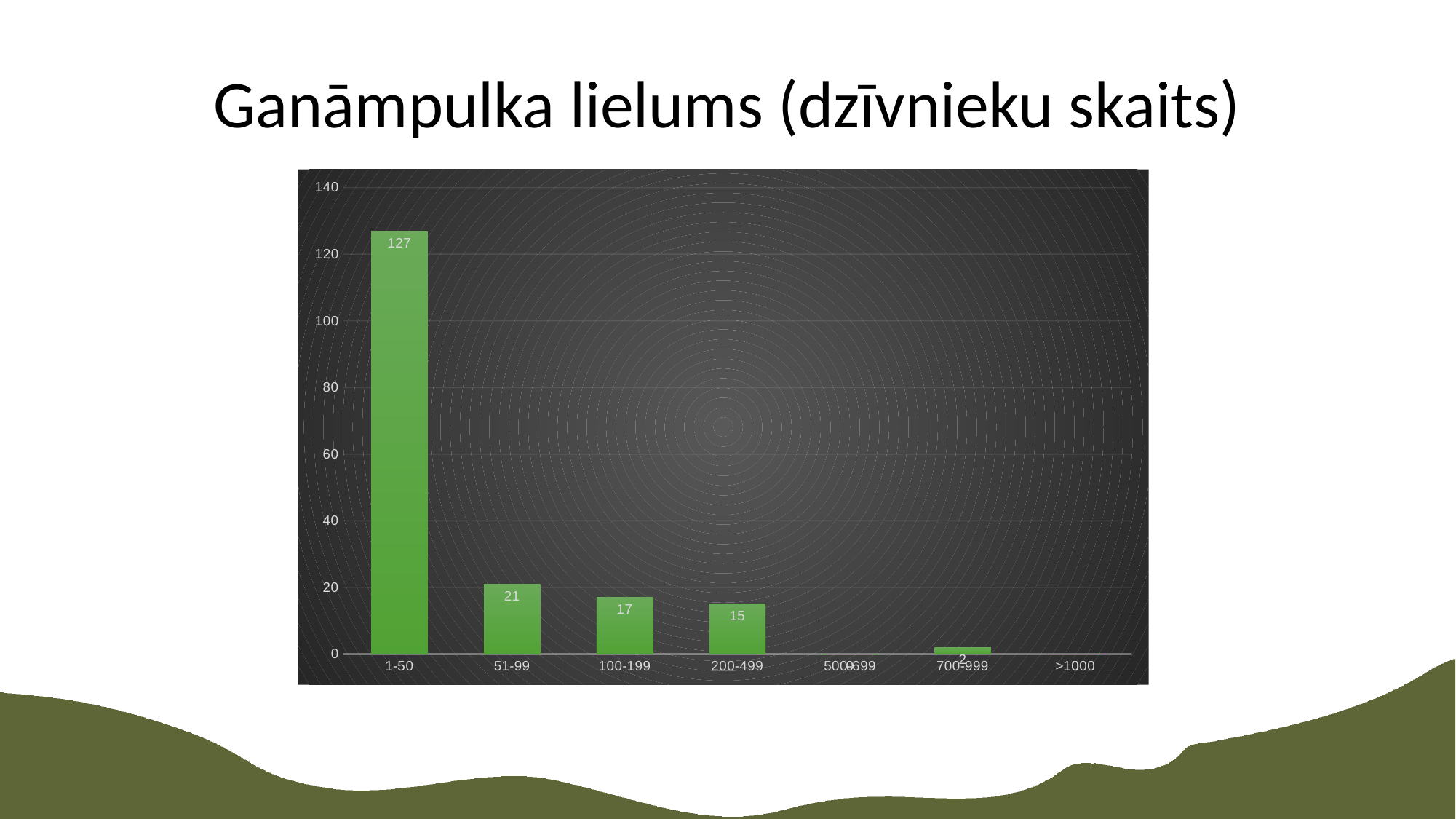
Which is larger, the value for 51-99 or the value for 200-499? 51-99 What is the value for the 700-999 category? 2 Which category has the highest value? 1-50 Is the value for 1-50 greater or less than 120? greater What is the value for the 100-199 category? 17 What is the value for the 1-50 category? 127 What is the difference between the values for 100-199 and 200-499? 2 What kind of chart is shown on the slide? bar chart How many categories are shown on the x axis? 7 What is the difference between the values for 1-50 and 51-99? 106 What is the value for the 200-499 category? 15 What is the value for the 51-99 category? 21